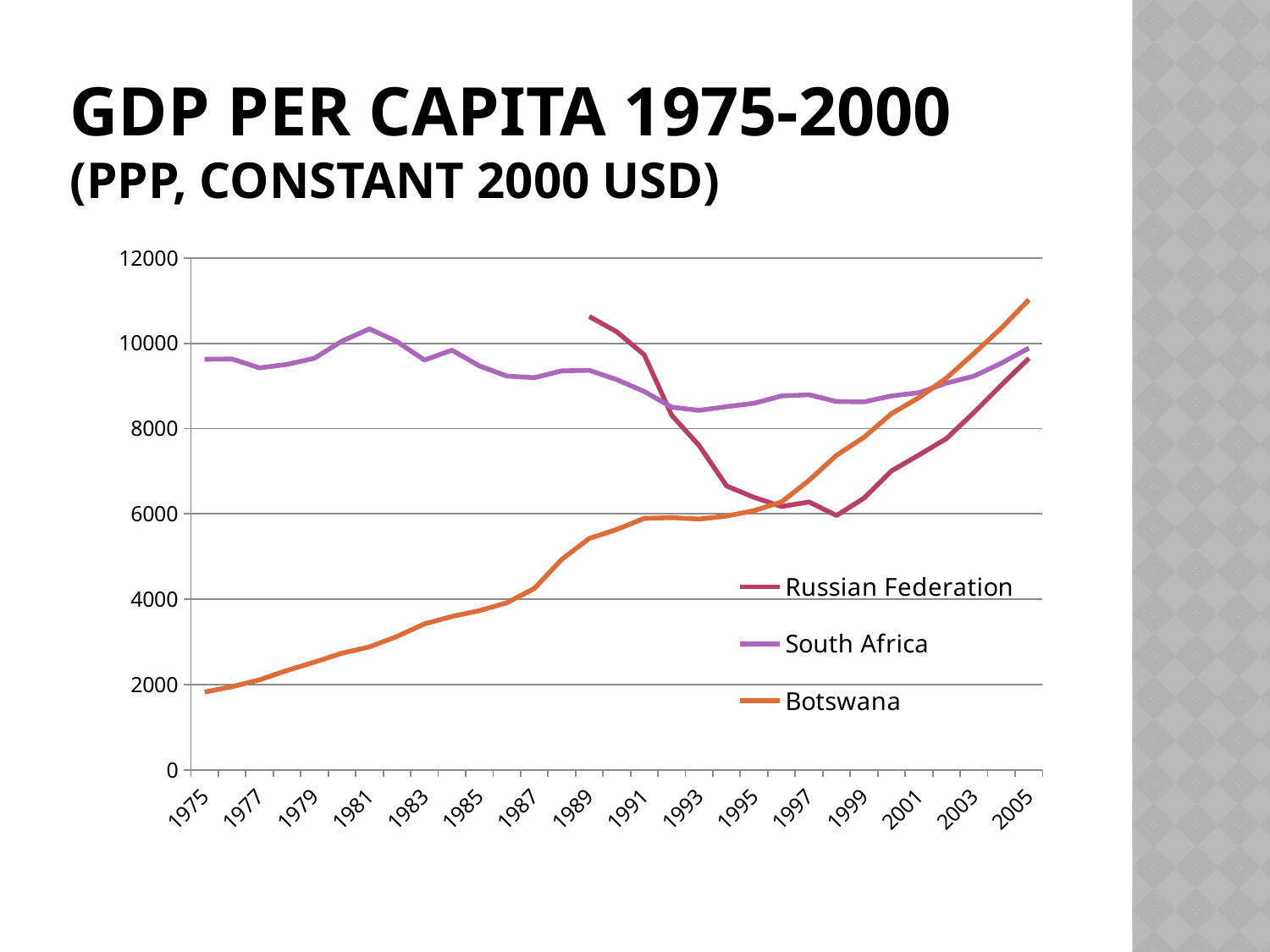
In 1989, which is higher: Russian Federation or South Africa? Russian Federation In 1998, which is higher: South Africa or Russian Federation? South Africa Does the Botswana line rise or fall from 1975 to 2005? Rises Which series has the highest value in 2005? Botswana What colour is the Botswana line? Orange Which series has the lowest value in 1975? Botswana What kind of chart is shown on the slide? Line chart Is the value for the Russian Federation in 1998 greater or less than 8000? less How many series does the legend list? 3 Is the value for Botswana in 2005 greater or less than 10000? greater Which series are listed in the legend? Russian Federation, South Africa, Botswana Does the Russian Federation line rise or fall from 1989 to 1998? Falls